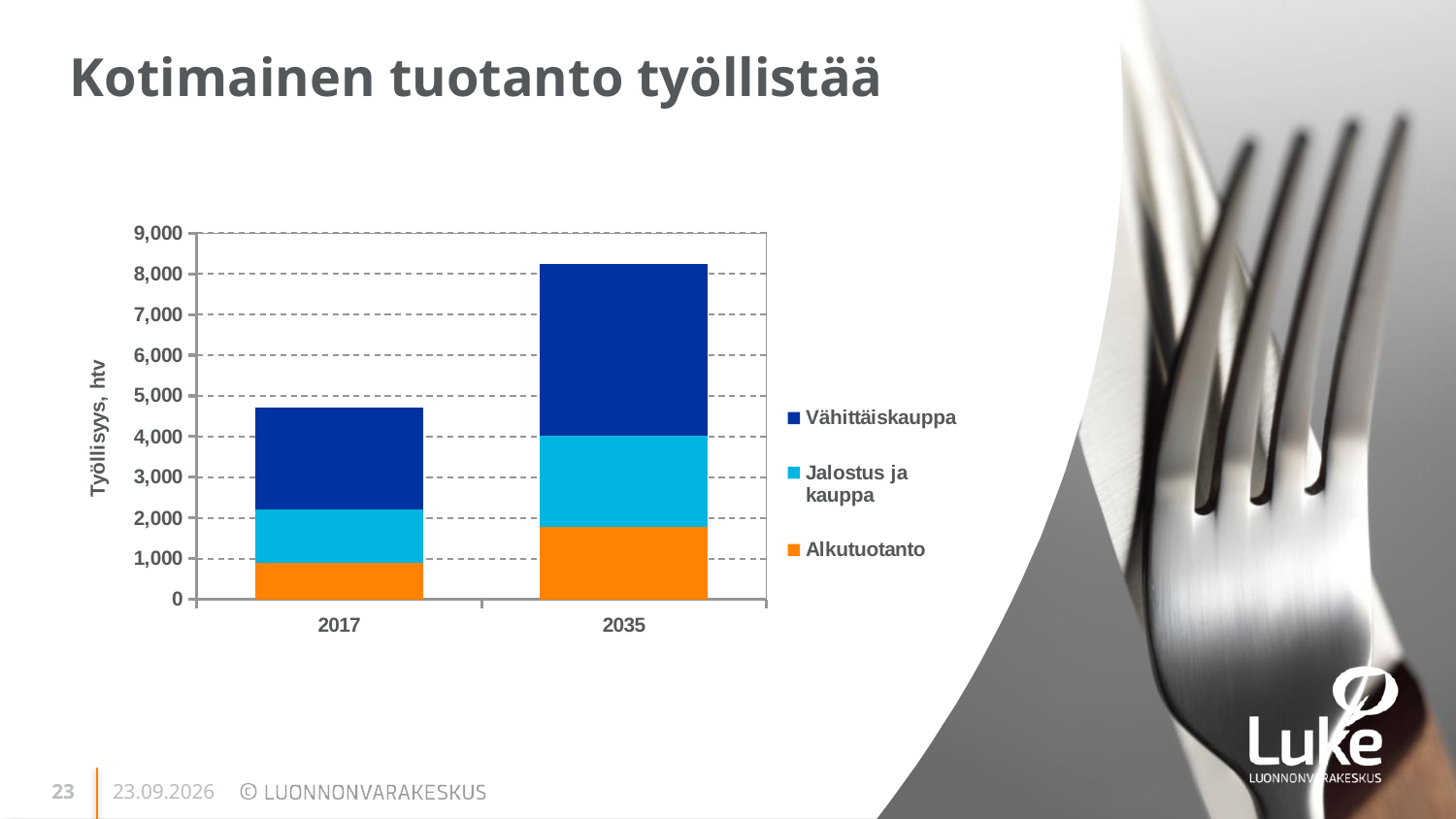
What is the label on the y axis of the chart? Työllisyys, htv Which year has the shorter stacked bar? 2017 What kind of chart is shown on the slide? Stacked bar chart Which series is shown in orange in the chart's legend? Alkutuotanto Is the total employment for 2035 greater or less than 8,000? greater Which year has the taller stacked bar, 2017 or 2035? 2035 Is the total employment for 2017 greater or less than 4,000? greater How many series does the chart's legend list? 3 Is the Alkutuotanto value for 2035 greater or less than 1,000? greater Does total employment rise or fall from 2017 to 2035? rise How many categories are shown on the x axis of the chart? 2